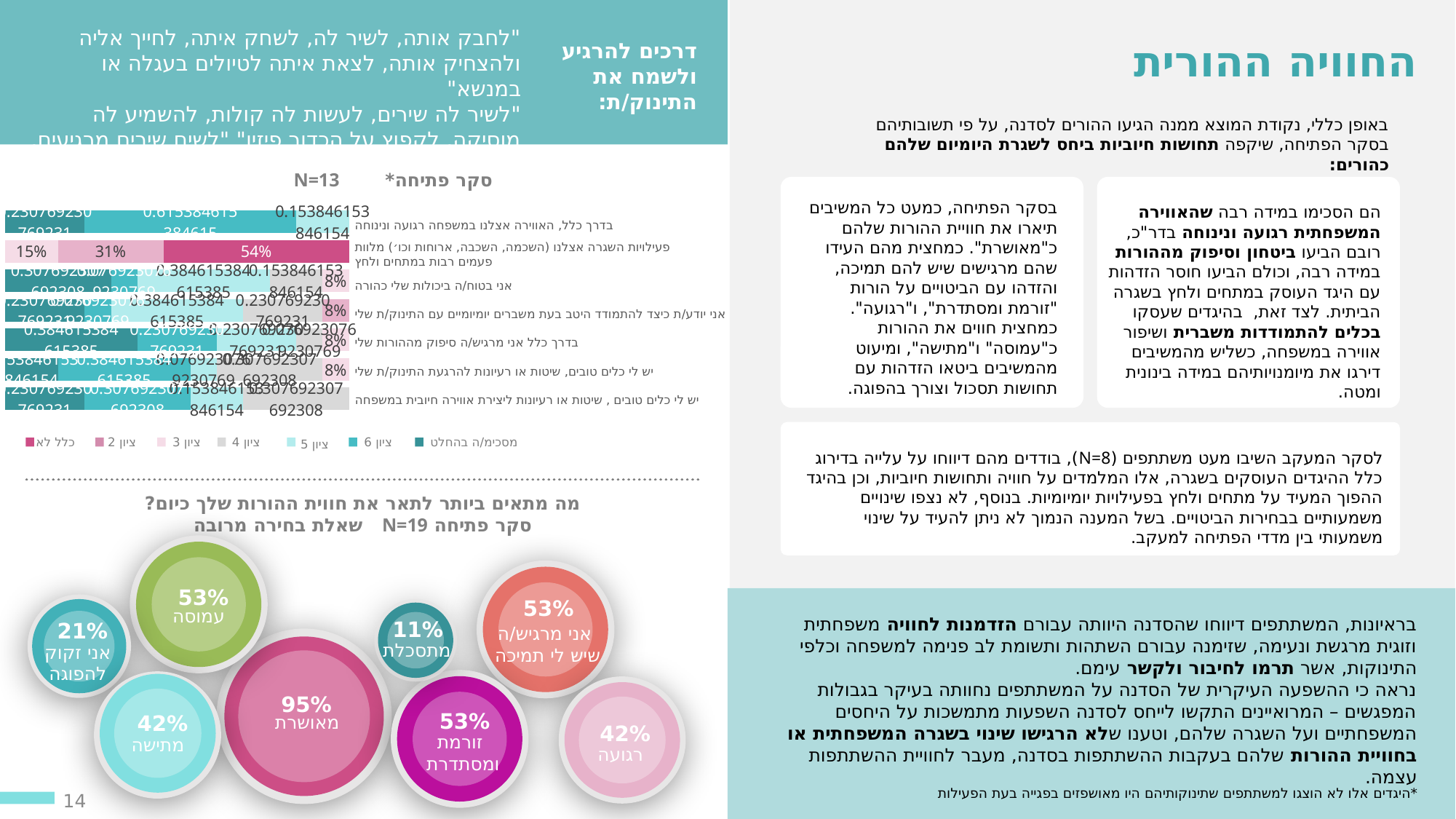
In the bubble chart at the bottom left, what percentage is shown for אני זקוק להפוגה? 21% In the bubble chart at the bottom left, what percentage is shown for מתסכלת? 11% How many entries does the legend of the stacked bar chart (סקר פתיחה) list? 7 In the bubble chart at the bottom left, what is the difference in percentage points between מאושרת and מתסכלת? 84 How many bubbles are shown in the bubble chart at the bottom left? 8 In the bubble chart at the bottom left, which label has the highest percentage? מאושרת In the bubble chart at the bottom left, what percentage is shown for מאושרת? 95% In the bubble chart at the bottom left, which label has the lowest percentage? מתסכלת In the bubble chart at the bottom left, which has a higher percentage: עמוסה or מתישה? עמוסה In the stacked bar chart (סקר פתיחה), what is the largest labelled segment value in the row for פעילויות השגרה? 54% What N value is shown in the title of the stacked bar chart (סקר פתיחה)? N=13 What kind of chart is the one at the bottom left of the slide? Bubble chart